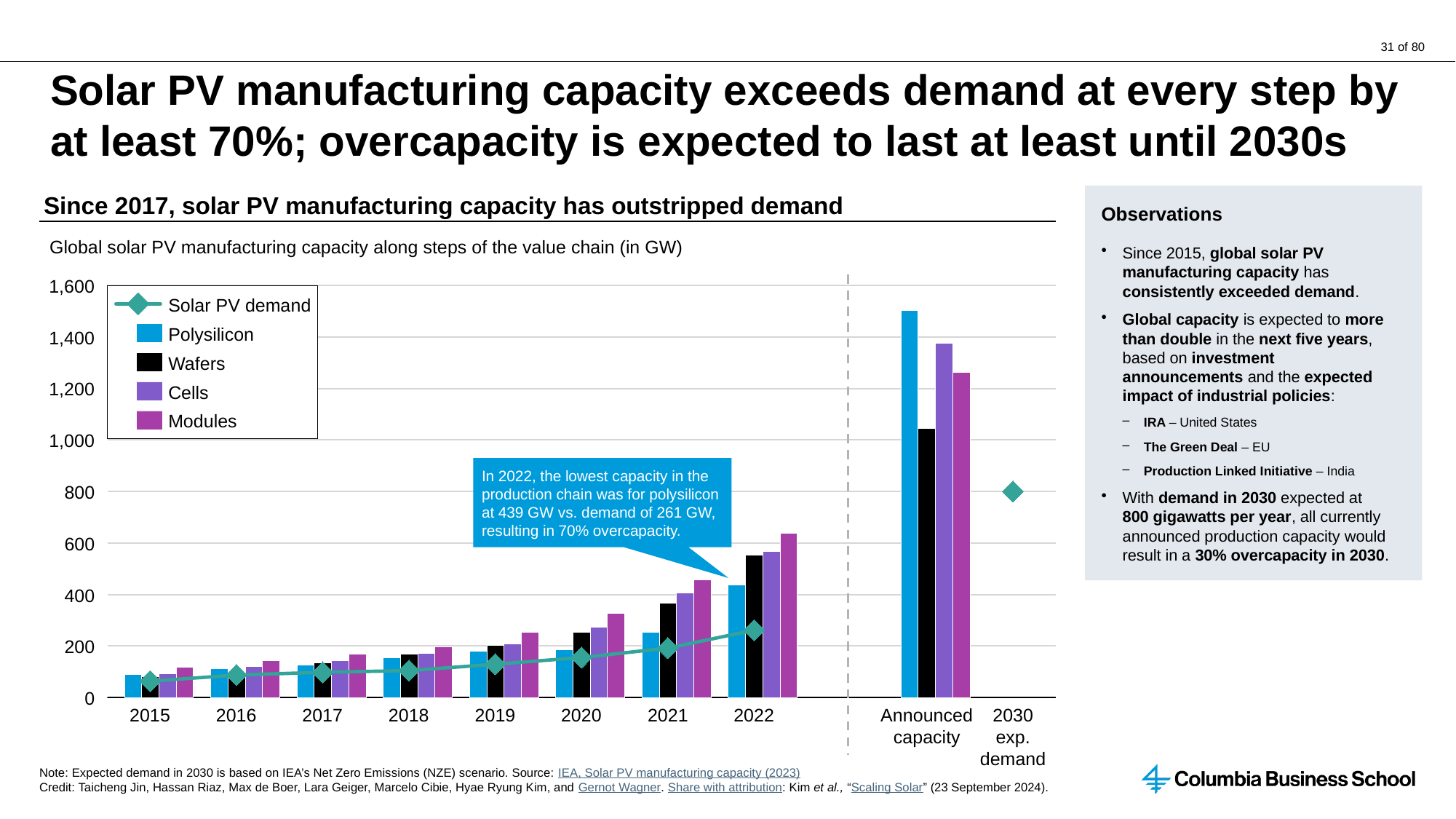
In 2022, which is larger: Modules capacity or Wafers capacity? Modules How do the manufacturing capacity values change from 2015 to 2022? They rise Is the announced capacity for Wafers greater or less than 1,000 GW? greater According to the callout, what was solar PV demand in 2022? 261 GW How many series does the chart legend list? 5 What is the difference between 2022 polysilicon capacity (439 GW) and 2022 demand (261 GW)? 178 GW Is the announced capacity for Polysilicon greater or less than 1,400 GW? greater Is the Modules capacity in 2022 greater or less than 600 GW? greater According to the callout, what was the polysilicon manufacturing capacity in 2022? 439 GW What kind of chart is shown on the slide? Bar chart (with a line for Solar PV demand) Which value-chain step has the highest announced capacity? Polysilicon Which value-chain step had the lowest manufacturing capacity in 2022? Polysilicon